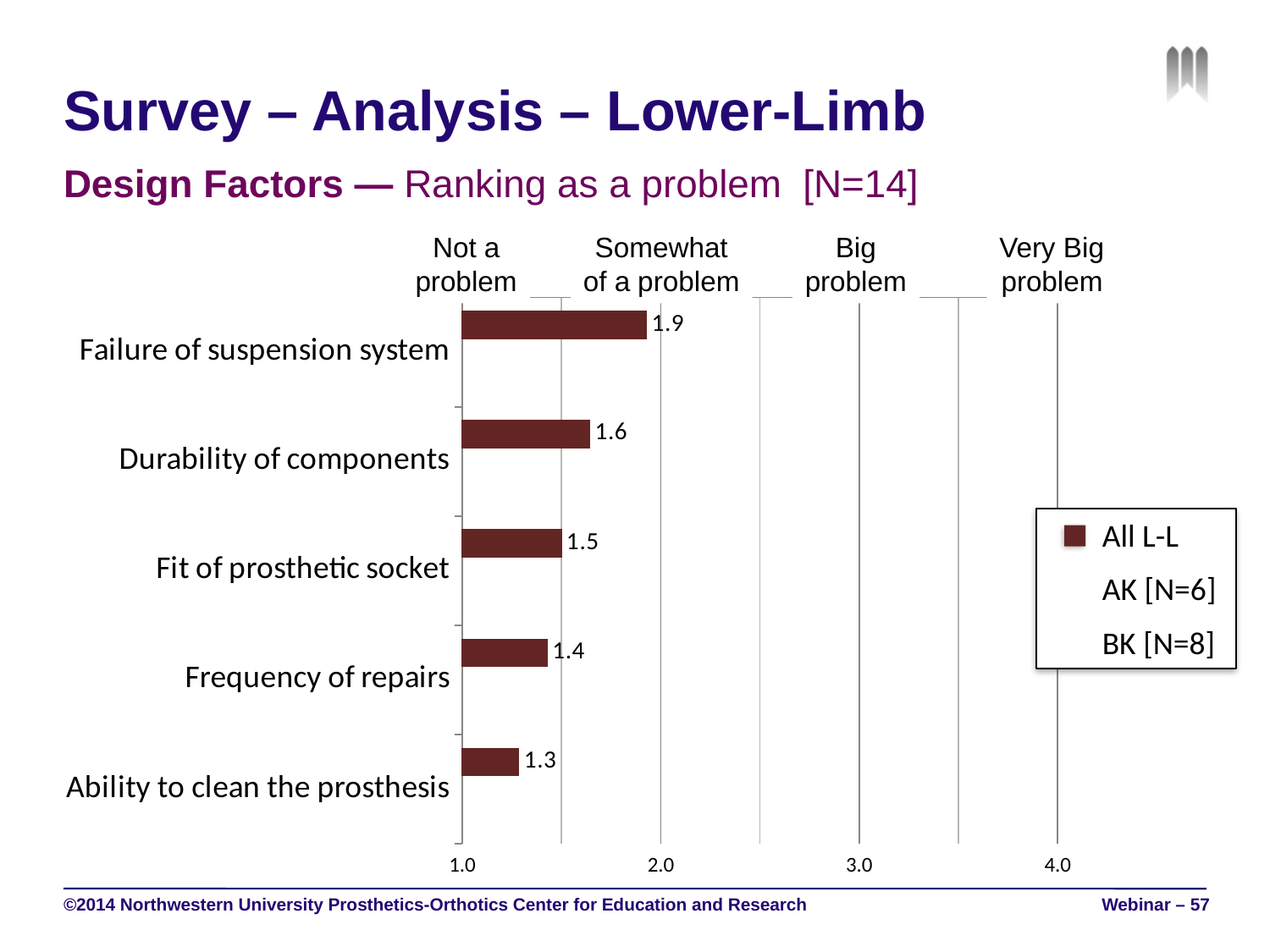
What is the difference between the values for Failure of suspension system and Ability to clean the prosthesis? 0.6 What is the value for Durability of components? 1.6 Which design factor has the highest value? Failure of suspension system What is the value for Frequency of repairs? 1.4 What is the value for Ability to clean the prosthesis? 1.3 How many entries does the chart legend list? 3 Which is larger, the value for Durability of components or the value for Fit of prosthetic socket? Durability of components How many design factors are plotted in the chart? 5 Which design factor has the lowest value? Ability to clean the prosthesis What kind of chart is shown on the slide? bar chart What is the value for Failure of suspension system? 1.9 Is the value for Failure of suspension system greater or less than 2.0? less